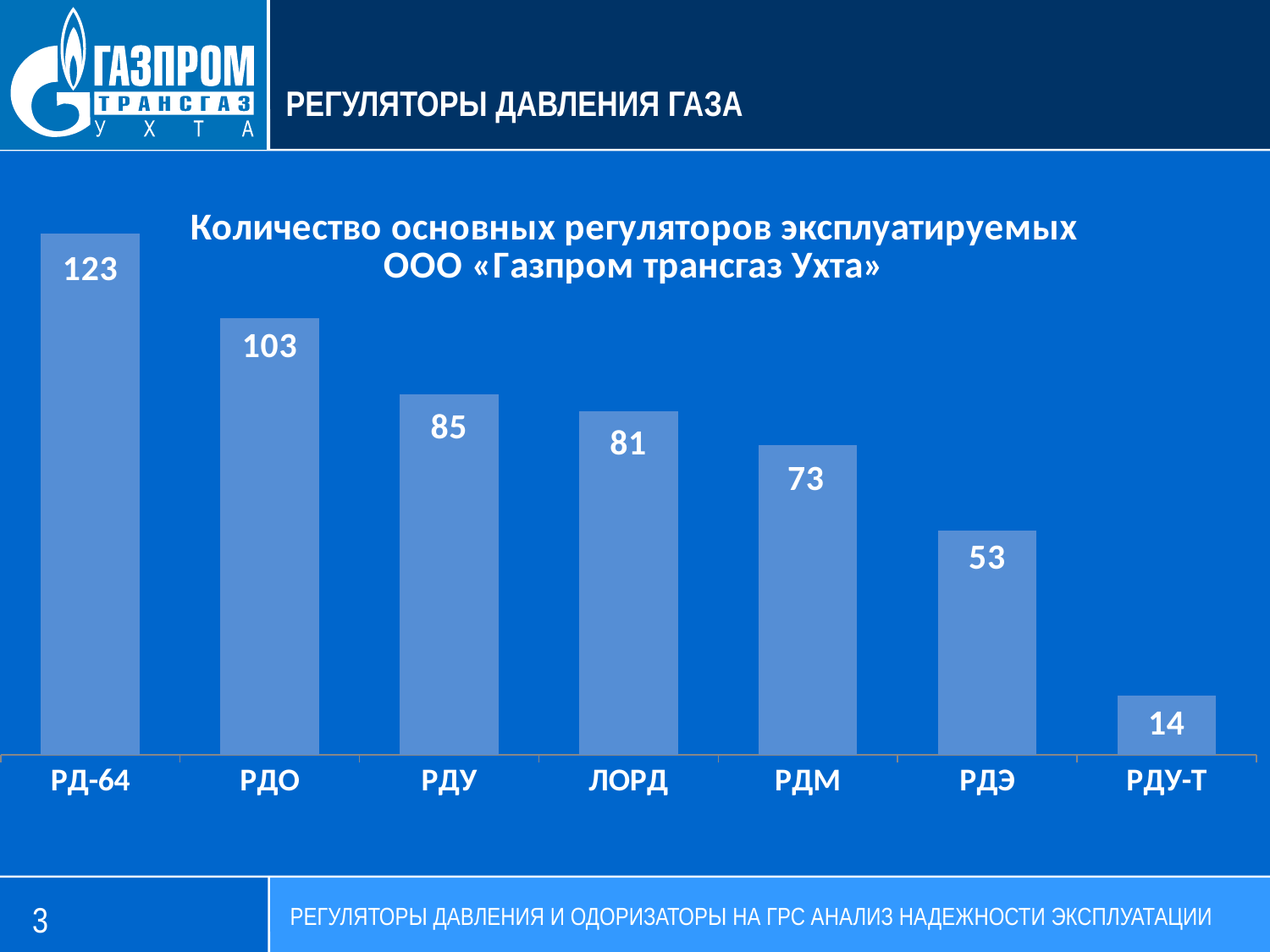
What is the difference between the values for РДМ and РДЭ? 20 What is the value for РДУ-Т? 14 What is the title of the chart? Количество основных регуляторов эксплуатируемых ООО «Газпром трансгаз Ухта» Which is larger, the value for РДУ or the value for ЛОРД? РДУ What kind of chart is this? Bar chart What is the value for ЛОРД? 81 Which category has the highest value? РД-64 How many categories are shown on the x axis? 7 Do the values rise or fall from left to right along the x axis? Fall What is the value for РД-64? 123 What is the difference between the values for РД-64 and РДО? 20 Which category has the lowest value? РДУ-Т